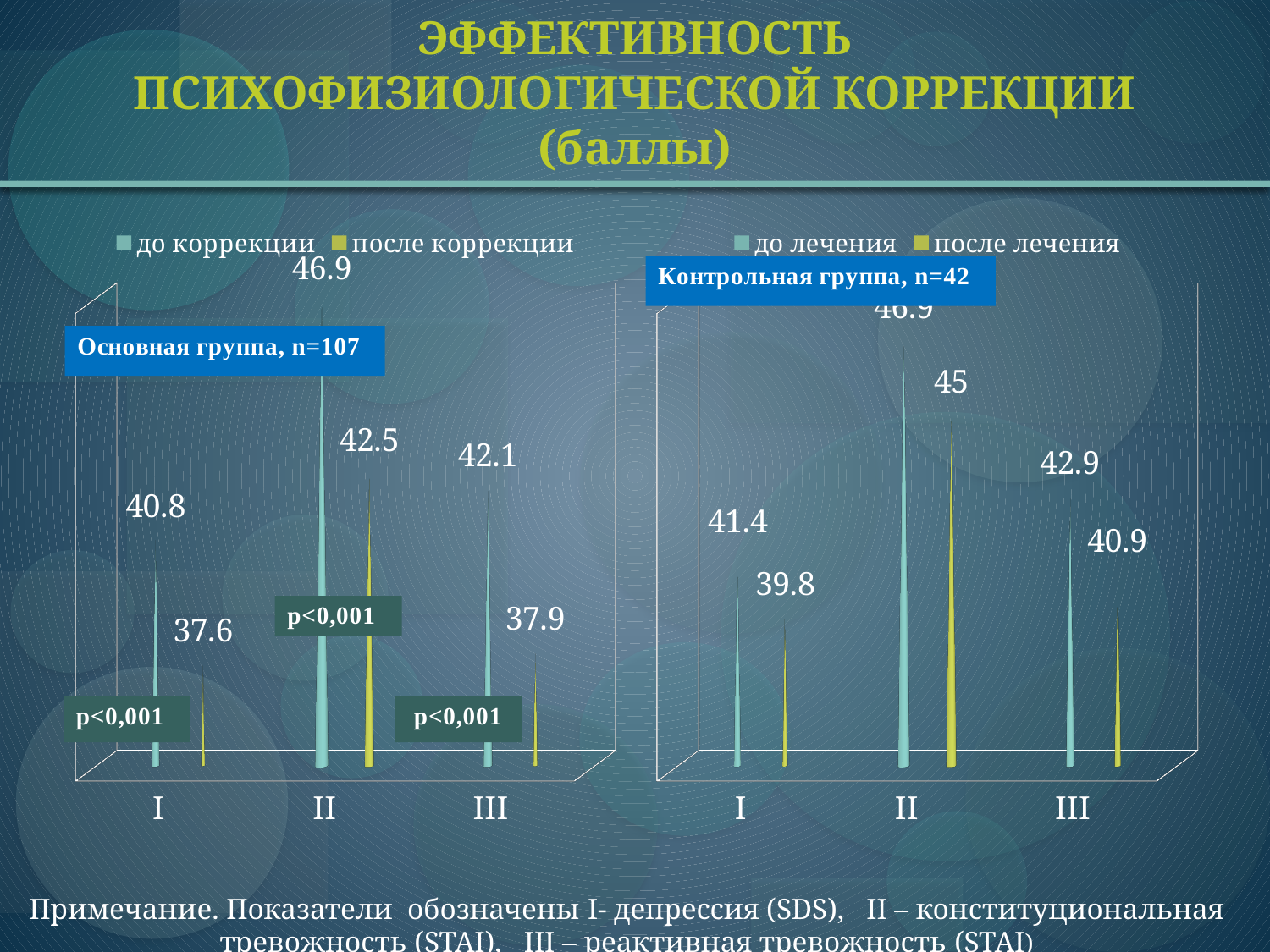
In the left chart (Основная группа, n=107), what is the difference between the before-correction and after-correction values for category II? 4.4 How many series does the legend of the left chart (Основная группа, n=107) list? 2 In the left chart (Основная группа, n=107), what is the value for category II before correction (до коррекции)? 46.9 In the left chart (Основная группа, n=107), which category has the lowest value after correction (после коррекции)? I In the right chart (Контрольная группа, n=42), what is the value for category II after treatment (после лечения)? 45 In the right chart (Контрольная группа, n=42), which is larger: the after-treatment value for category II or the after-treatment value for category III? category II In the left chart (Основная группа, n=107), what is the value for category III before correction (до коррекции)? 42.1 In the right chart (Контрольная группа, n=42), what is the value for category III after treatment (после лечения)? 40.9 In the left chart (Основная группа, n=107), what is the value for category I after correction (после коррекции)? 37.6 In the right chart (Контрольная группа, n=42), what is the difference between the before-treatment and after-treatment values for category III? 2 In the left chart (Основная группа, n=107), which category has the highest value before correction (до коррекции)? II In the right chart (Контрольная группа, n=42), what is the value for category I before treatment (до лечения)? 41.4